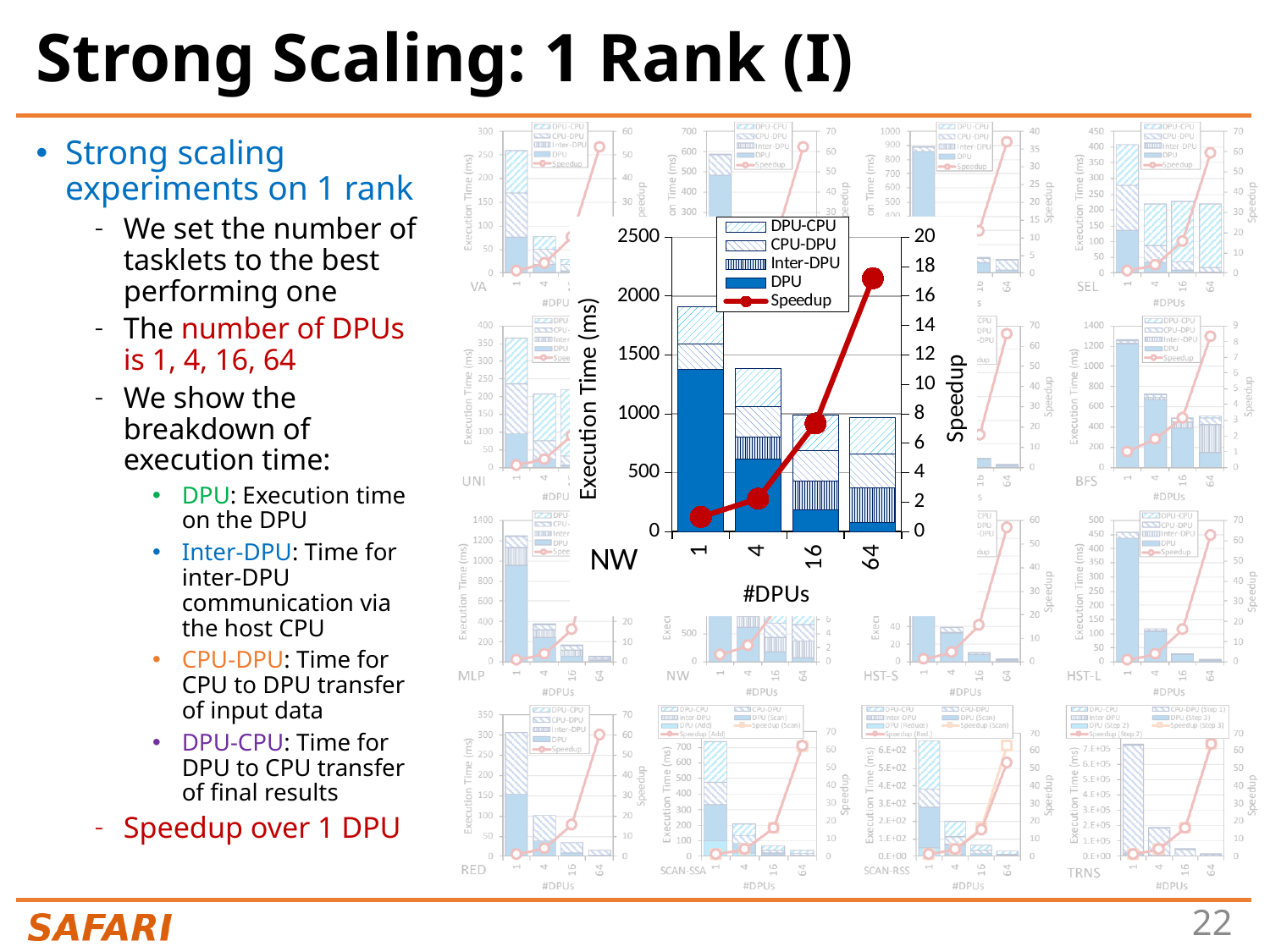
In the enlarged NW chart, how many #DPUs categories are shown on the x axis? 4 In the enlarged NW chart, is the total execution time for 4 DPUs greater or less than 1500 ms? less In the enlarged NW chart, which #DPUs value has the highest total execution time? 1 In the enlarged NW chart, what kind of chart is used to show the execution time breakdown? Stacked bar chart (with a line for Speedup) In the enlarged NW chart, which legend entry is plotted as a line rather than as bars? Speedup In the enlarged NW chart, does the Speedup line rise or fall as #DPUs increases from 1 to 64? Rises In the enlarged NW chart, which has the larger total execution time: 1 DPU or 4 DPUs? 1 DPU In the enlarged NW chart, what is the label of the right-hand y axis? Speedup In the enlarged NW chart, how many entries does the legend list? 5 In the enlarged NW chart, is the total execution time for 1 DPU greater or less than 1500 ms? greater In the enlarged NW chart, is the Speedup for 64 DPUs greater or less than 10? greater